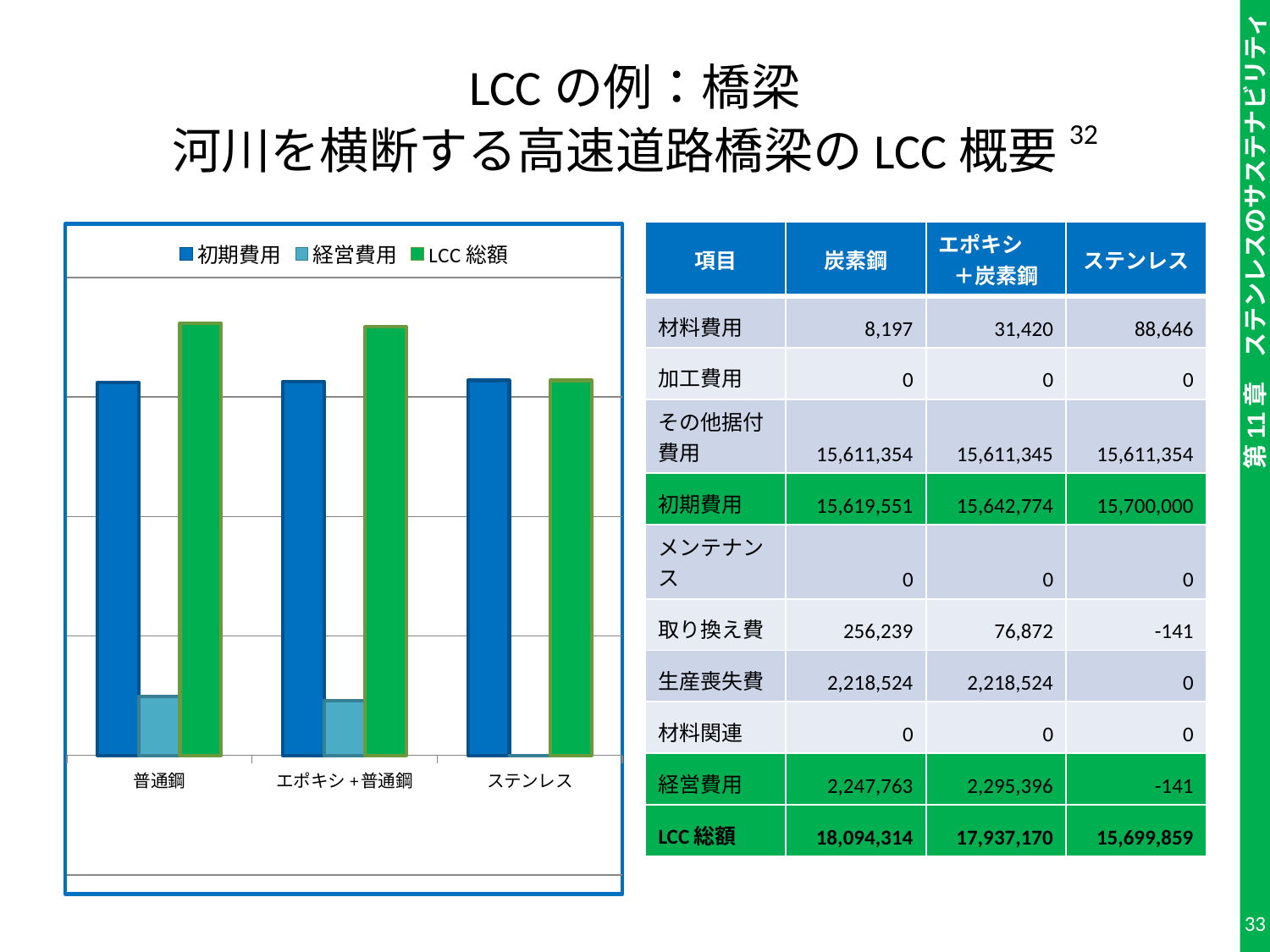
Which category has the highest 経営費用 bar in the chart? 普通鋼 Do the LCC 総額 bars rise or fall from left to right across the categories? fall For 普通鋼, which is larger in the chart: the 初期費用 bar or the LCC 総額 bar? LCC 総額 What kind of chart is shown on the left of the slide? bar chart What is the label of the middle category on the x axis of the chart? エポキシ+普通鋼 What colour are the LCC 総額 bars in the chart? green How many series does the legend of the bar chart list? 3 What are the three series listed in the chart legend? 初期費用, 経営費用, LCC 総額 Which category has the lowest LCC 総額 bar in the chart? ステンレス How many categories are shown on the x axis of the bar chart? 3 Which is larger in the chart: the 経営費用 bar for 普通鋼 or the 経営費用 bar for ステンレス? 普通鋼 Which category has the lowest 経営費用 bar in the chart? ステンレス